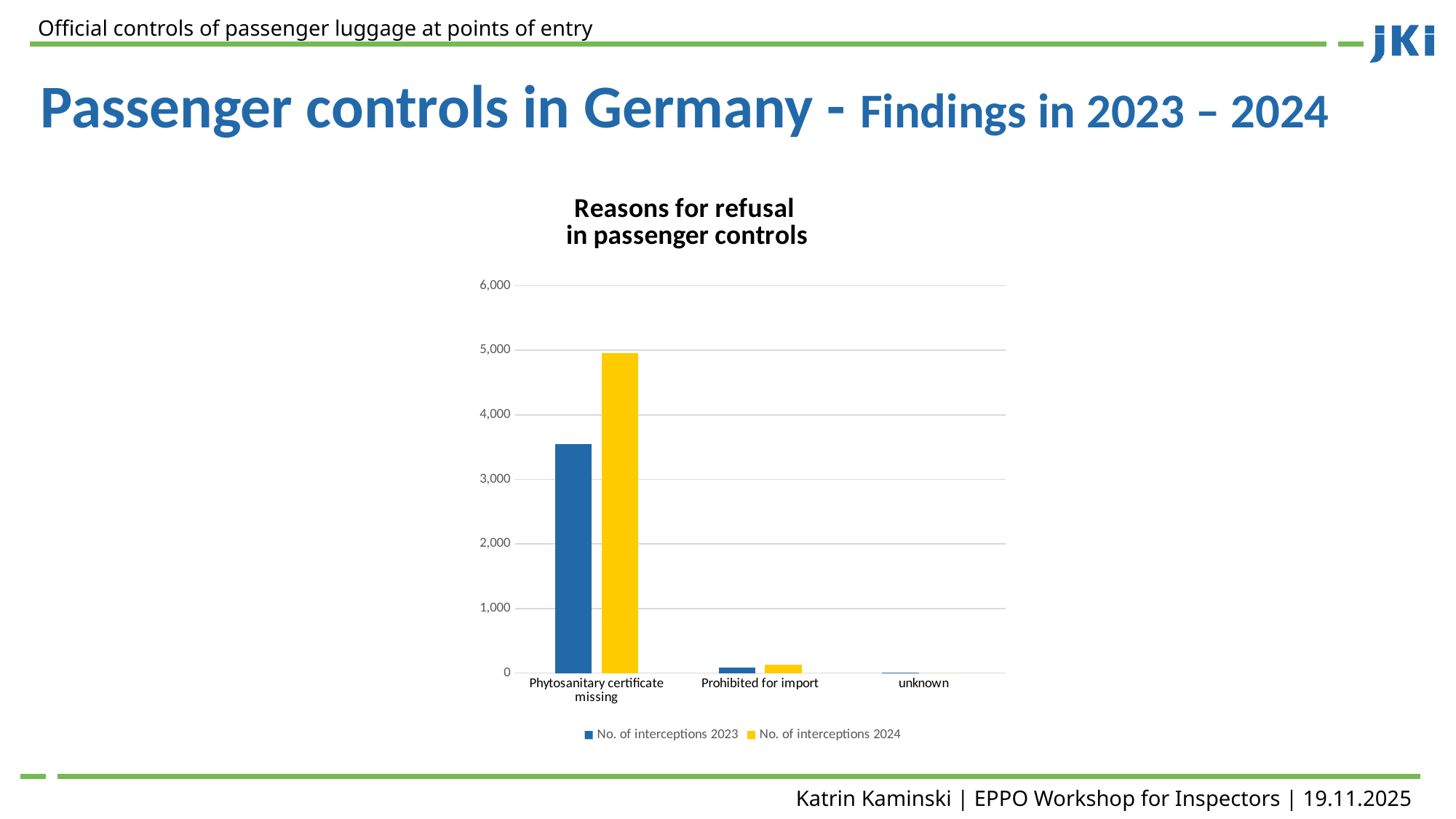
Which category has the lowest number of interceptions in 2023? unknown What kind of chart is shown on the slide? bar chart How many categories are shown on the x axis of the chart? 3 Which category has a larger number of interceptions in 2023, Phytosanitary certificate missing or Prohibited for import? Phytosanitary certificate missing How many series does the chart's legend list? 2 Which colour represents No. of interceptions 2024 in the chart? yellow Which category has the highest number of interceptions in 2024? Phytosanitary certificate missing What is the title of the chart? Reasons for refusal in passenger controls Is the value for No. of interceptions 2024 for Prohibited for import greater or less than 1,000? less Is the value for No. of interceptions 2024 for Phytosanitary certificate missing greater or less than 4,000? greater Is the value for No. of interceptions 2023 for Phytosanitary certificate missing greater or less than 3,000? greater For Phytosanitary certificate missing, which year has more interceptions, 2023 or 2024? 2024